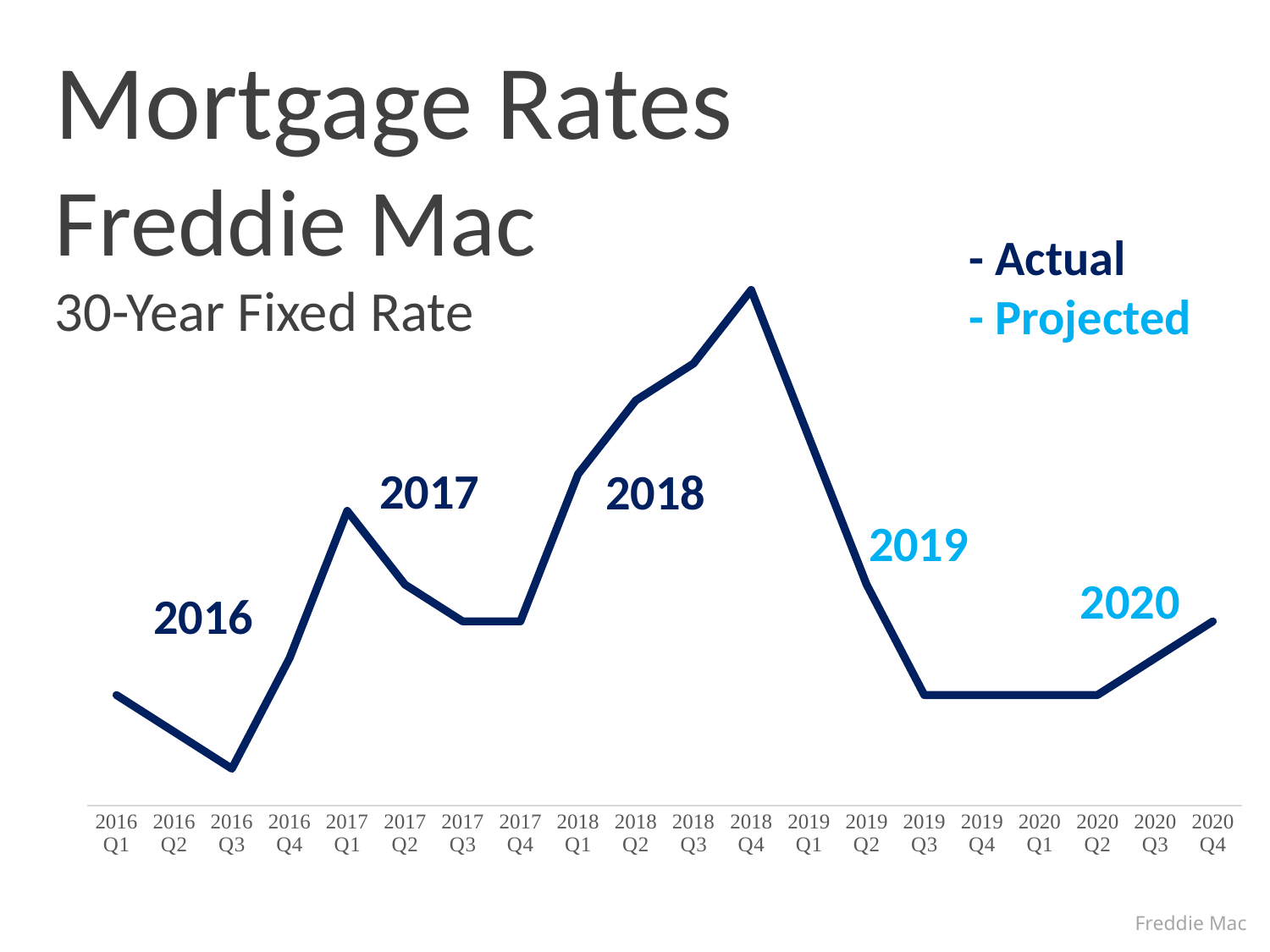
Which is higher, the rate in 2017 Q1 or the rate in 2016 Q3? 2017 Q1 What kind of chart is shown on the slide? line chart What are the two entries in the chart's legend? Actual and Projected What is the source cited at the bottom of the chart? Freddie Mac Does the mortgage rate rise or fall from 2017 Q4 to 2018 Q4? rise Does the mortgage rate rise or fall from 2020 Q2 to 2020 Q4? rise How many quarterly points are plotted along the x axis? 20 Which quarter has the lowest mortgage rate on the chart? 2016 Q3 Which quarter has the highest mortgage rate on the chart? 2018 Q4 How many entries does the legend list? 2 Does the mortgage rate rise or fall from 2018 Q4 to 2019 Q3? fall Which is higher, the rate in 2018 Q4 or the rate in 2019 Q3? 2018 Q4